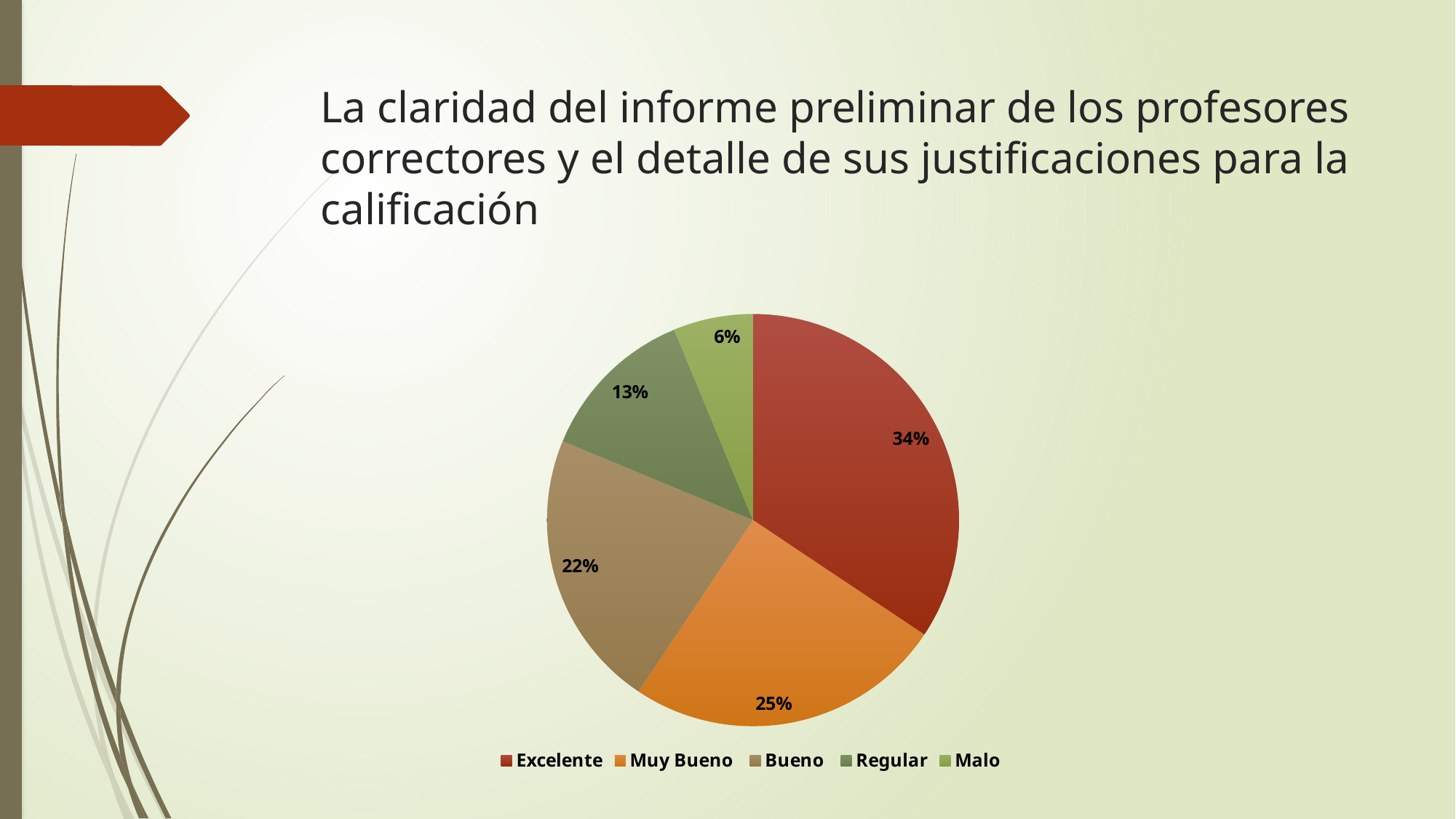
What is the difference in percentage points between Excelente and Regular? 21 What percentage of the pie is labelled Regular? 13% What percentage of the pie is labelled Malo? 6% Which is larger, the Muy Bueno slice or the Bueno slice? Muy Bueno Which category has the smallest slice of the pie? Malo How many categories does the pie chart have? 5 Which category has the largest slice of the pie? Excelente What kind of chart is shown on the slide? pie chart What percentage of the pie is labelled Bueno? 22% What percentage of the pie is labelled Muy Bueno? 25% What percentage of the pie is labelled Excelente? 34% Which colour represents the Malo category in the legend? light green